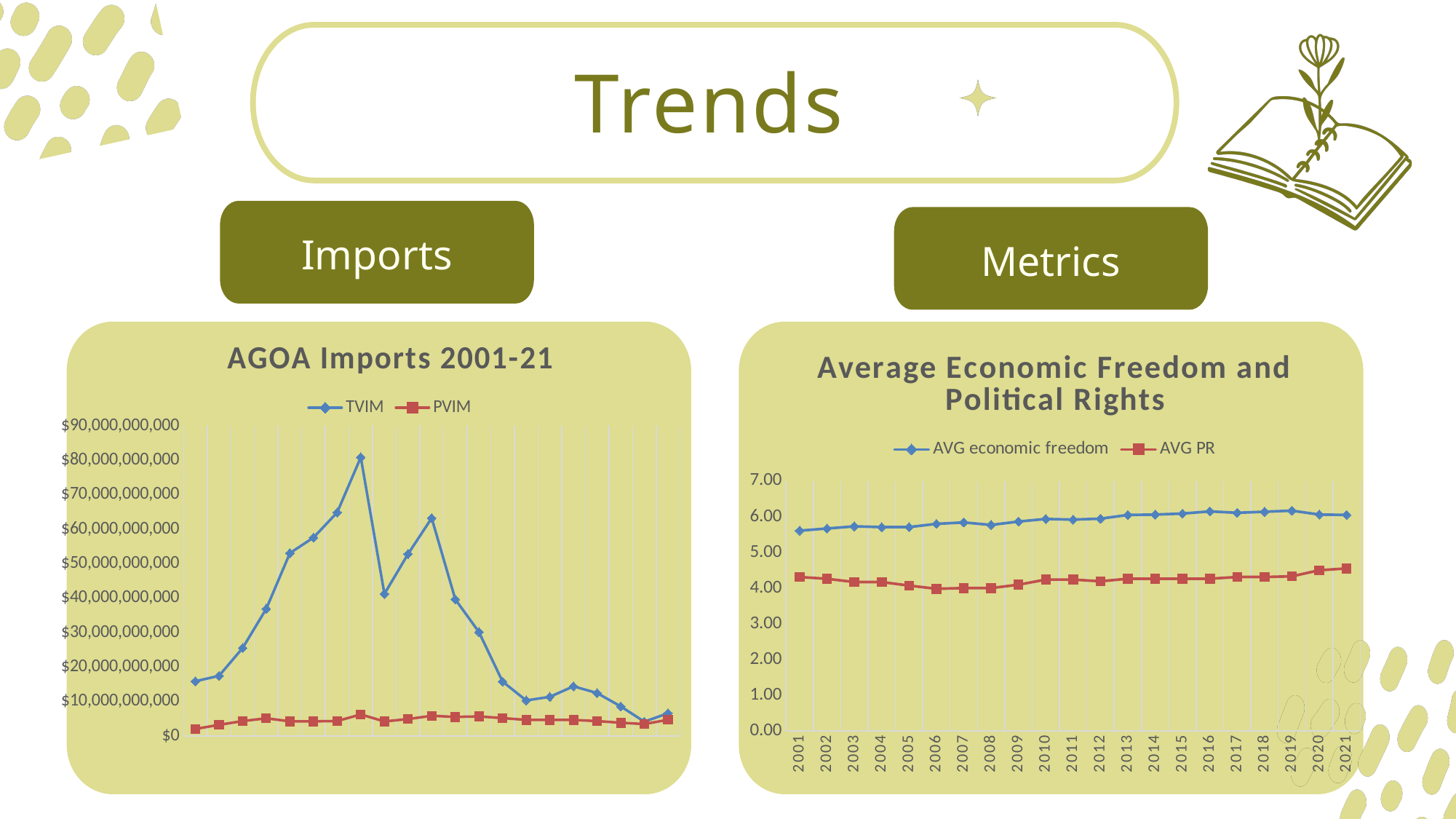
In the 'Average Economic Freedom and Political Rights' chart, which series has the higher values, AVG economic freedom or AVG PR? AVG economic freedom How many years are plotted on the x axis of the 'Average Economic Freedom and Political Rights' chart? 21 What are the two series listed in the legend of the 'Average Economic Freedom and Political Rights' chart? AVG economic freedom and AVG PR In the 'AGOA Imports 2001-21' chart, is the peak value of the TVIM series greater or less than $70,000,000,000? greater In the 'Average Economic Freedom and Political Rights' chart, does the AVG economic freedom series generally rise or fall from 2001 to 2021? rise What is the title of the chart on the left of the slide? AGOA Imports 2001-21 In the 'AGOA Imports 2001-21' chart, which series has the higher values throughout, TVIM or PVIM? TVIM What type of chart is the 'Average Economic Freedom and Political Rights' chart? line chart What type of chart is the 'AGOA Imports 2001-21' chart? line chart In the 'Average Economic Freedom and Political Rights' chart, is the AVG economic freedom value for 2001 greater or less than 5.00? greater In the 'AGOA Imports 2001-21' chart, is the highest PVIM value greater or less than $10,000,000,000? less How many series does the legend of the 'AGOA Imports 2001-21' chart list? 2